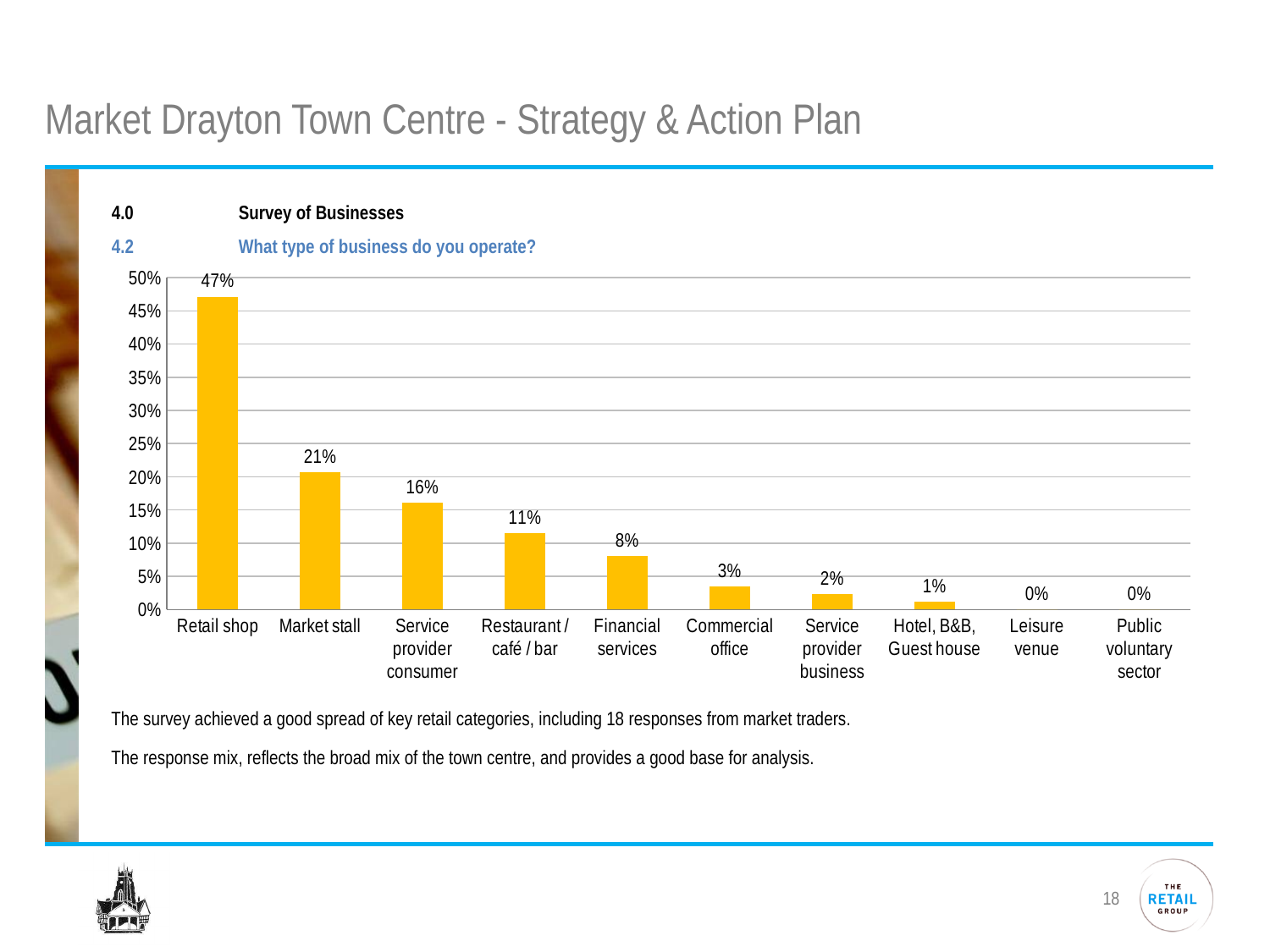
What is the difference between the values for Service provider consumer and Restaurant / café / bar? 5% What is the value for Hotel, B&B, Guest house? 1% What percentage of respondents operate a retail shop? 47% Which business type has the highest percentage? Retail shop What is the difference between the values for Retail shop and Market stall? 26% Do the values rise or fall from left to right along the x axis? Fall What question does the chart answer, as given in its heading? What type of business do you operate? How many business categories are shown on the x axis? 10 What is the value for Financial services? 8% Which is larger, the value for Commercial office or the value for Service provider business? Commercial office What kind of chart is shown on the slide? Bar chart What is the value for Market stall? 21%